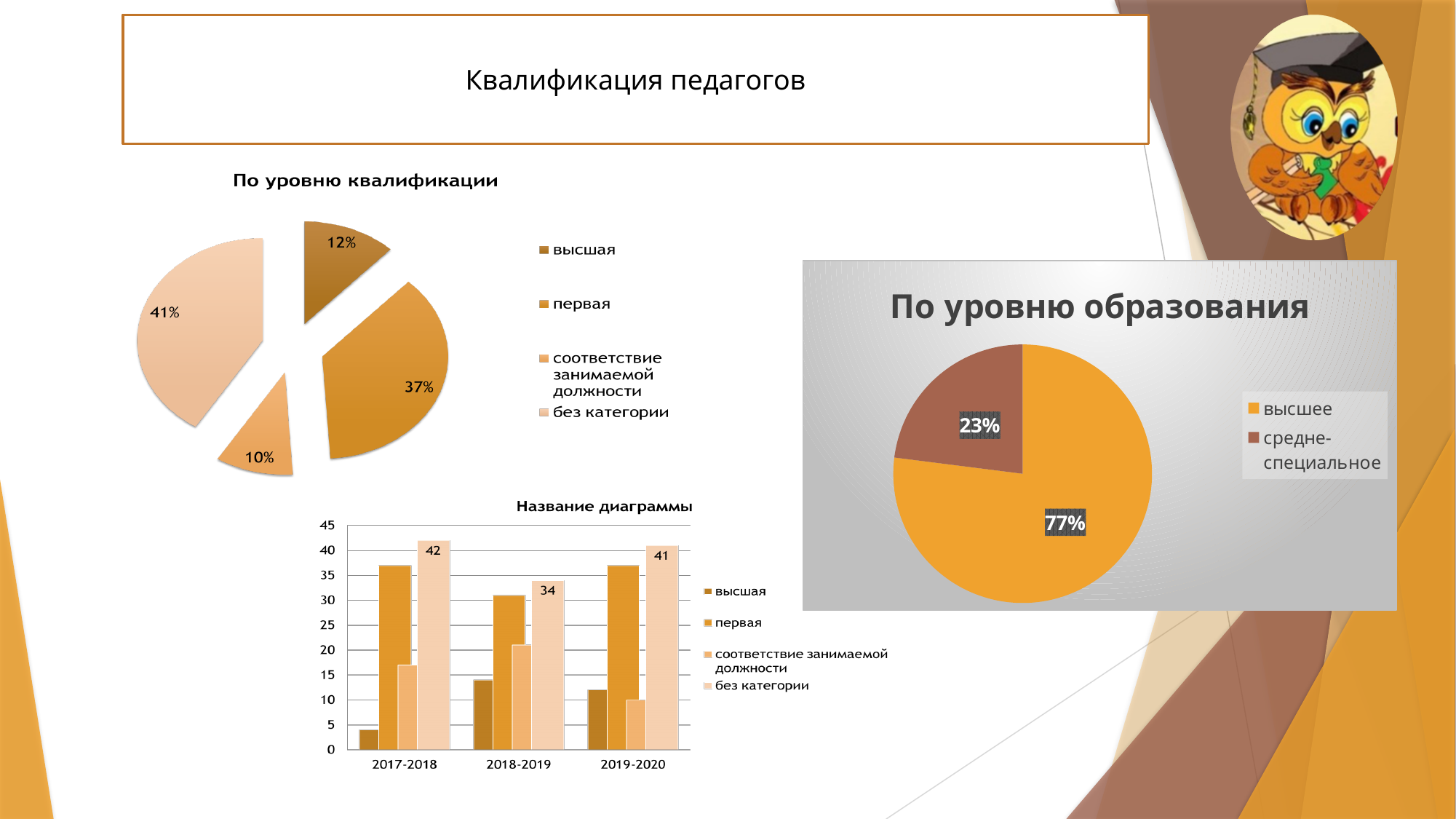
In the bar chart 'Название диаграммы', what is the value of 'без категории' for 2018-2019? 34 In the pie chart 'По уровню квалификации', what share is labelled for 'первая'? 37% In the pie chart 'По уровню квалификации', how many categories does the legend list? 4 In the pie chart 'По уровню квалификации', what share is labelled for 'высшая'? 12% In the bar chart 'Название диаграммы', what is the difference between the 'без категории' values for 2017-2018 and 2019-2020? 1 In the pie chart 'По уровню квалификации', which category has the largest share? без категории In the pie chart 'По уровню квалификации', which category has the smallest share? соответствие занимаемой должности What kind of chart is the chart titled 'Название диаграммы'? bar chart In the pie chart 'По уровню образования', what share is labelled for 'высшее'? 77% In the bar chart 'Название диаграммы', how many series does the legend list? 4 In the pie chart 'По уровню образования', what is the difference between the 'высшее' and 'средне-специальное' shares? 54% In the bar chart 'Название диаграммы', is the value for 'высшая' in 2017-2018 greater or less than 10? less